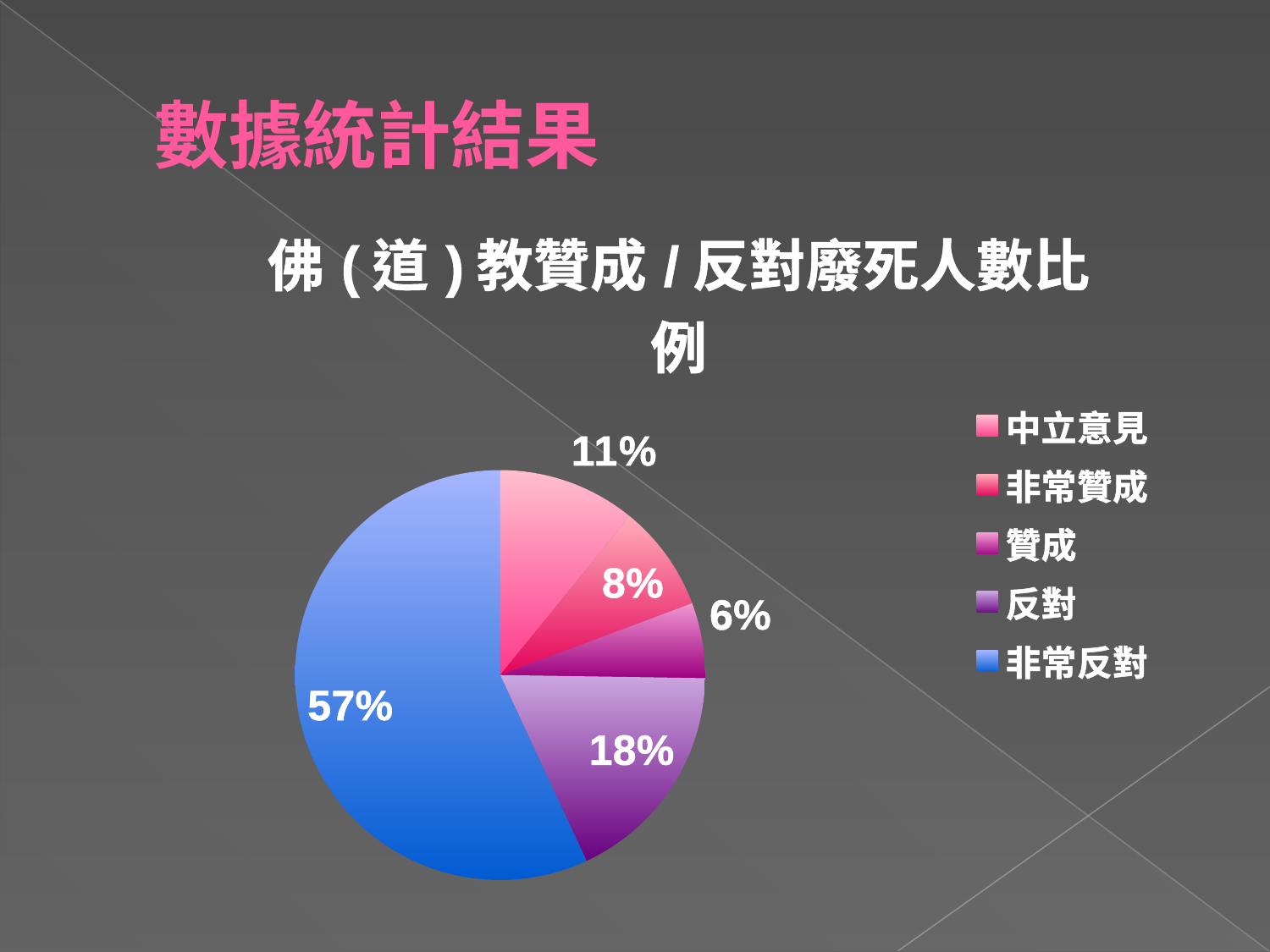
What percentage of the pie is 中立意見? 11% Which category has the largest share of the pie? 非常反對 What kind of chart is shown on the slide? pie chart What percentage of the pie is 非常贊成? 8% What is the difference in percentage points between 非常反對 and 反對? 39 Which category has the smallest share of the pie? 贊成 What percentage of the pie is 反對? 18% What is the title of the chart? 佛(道)教贊成/反對廢死人數比例 How many categories does the legend list? 5 Which is larger, the share for 中立意見 or the share for 非常贊成? 中立意見 What percentage of the pie is 非常反對? 57% What percentage of the pie is 贊成? 6%